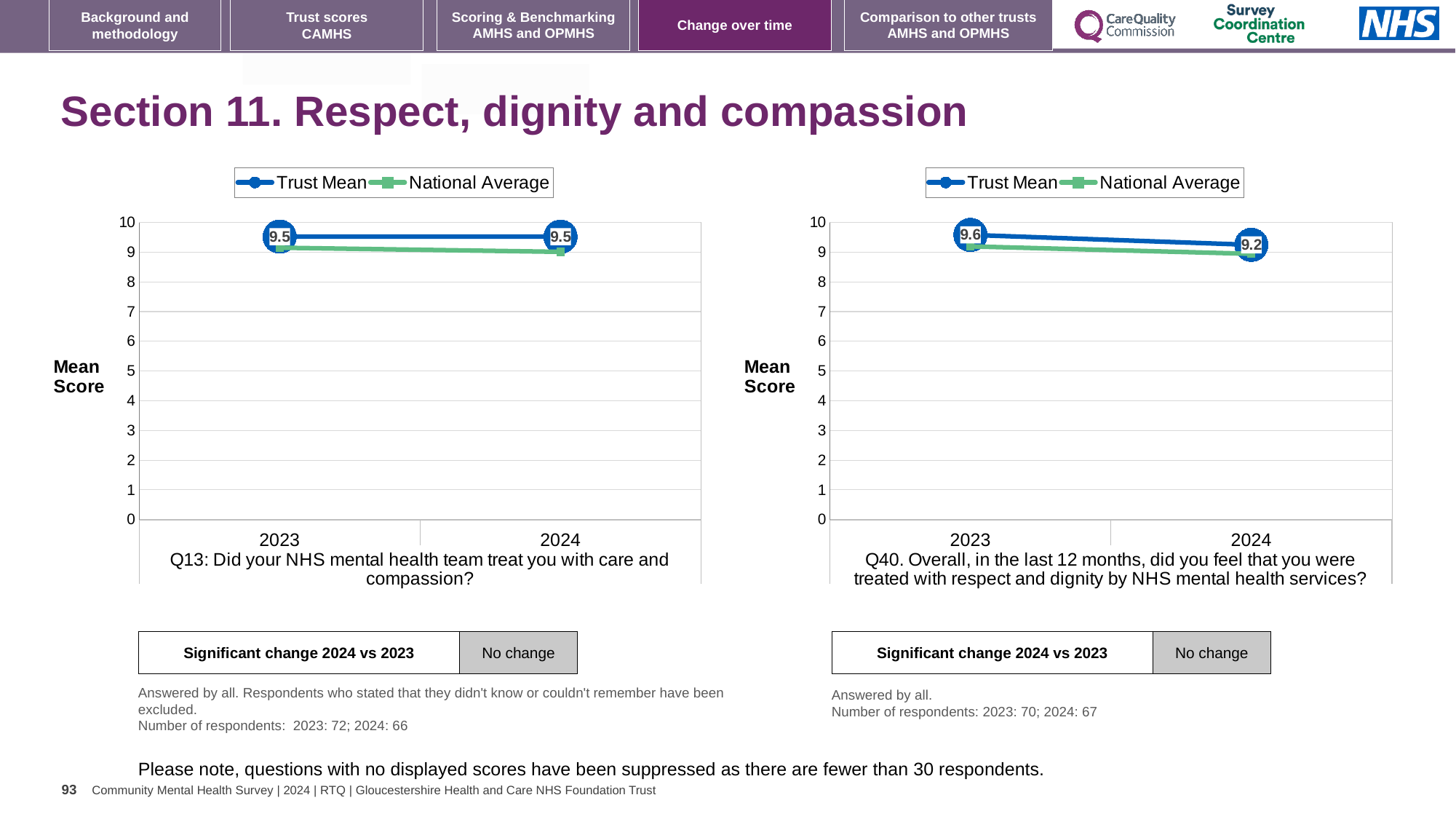
In the Q13 chart on the left, does the Trust Mean rise, fall or stay the same from 2023 to 2024? stays the same How many years are plotted on the x axis of the Q13 chart on the left? 2 In the Q13 chart on the left, which series is higher in 2024, Trust Mean or National Average? Trust Mean In the Q40 chart on the right, what is the Trust Mean for 2023? 9.6 In the Q13 chart on the left, is the National Average for 2024 greater or less than 8? greater In the Q13 chart on the left, what is the Trust Mean for 2023? 9.5 How many series does the legend of the Q40 chart on the right list? 2 In the Q13 chart on the left, what is the Trust Mean for 2024? 9.5 What kind of chart is the Q13 chart on the left? line chart In the Q40 chart on the right, what is the Trust Mean for 2024? 9.2 In the Q40 chart on the right, does the Trust Mean rise or fall from 2023 to 2024? fall In the Q40 chart on the right, by how much did the Trust Mean change from 2023 to 2024? 0.4